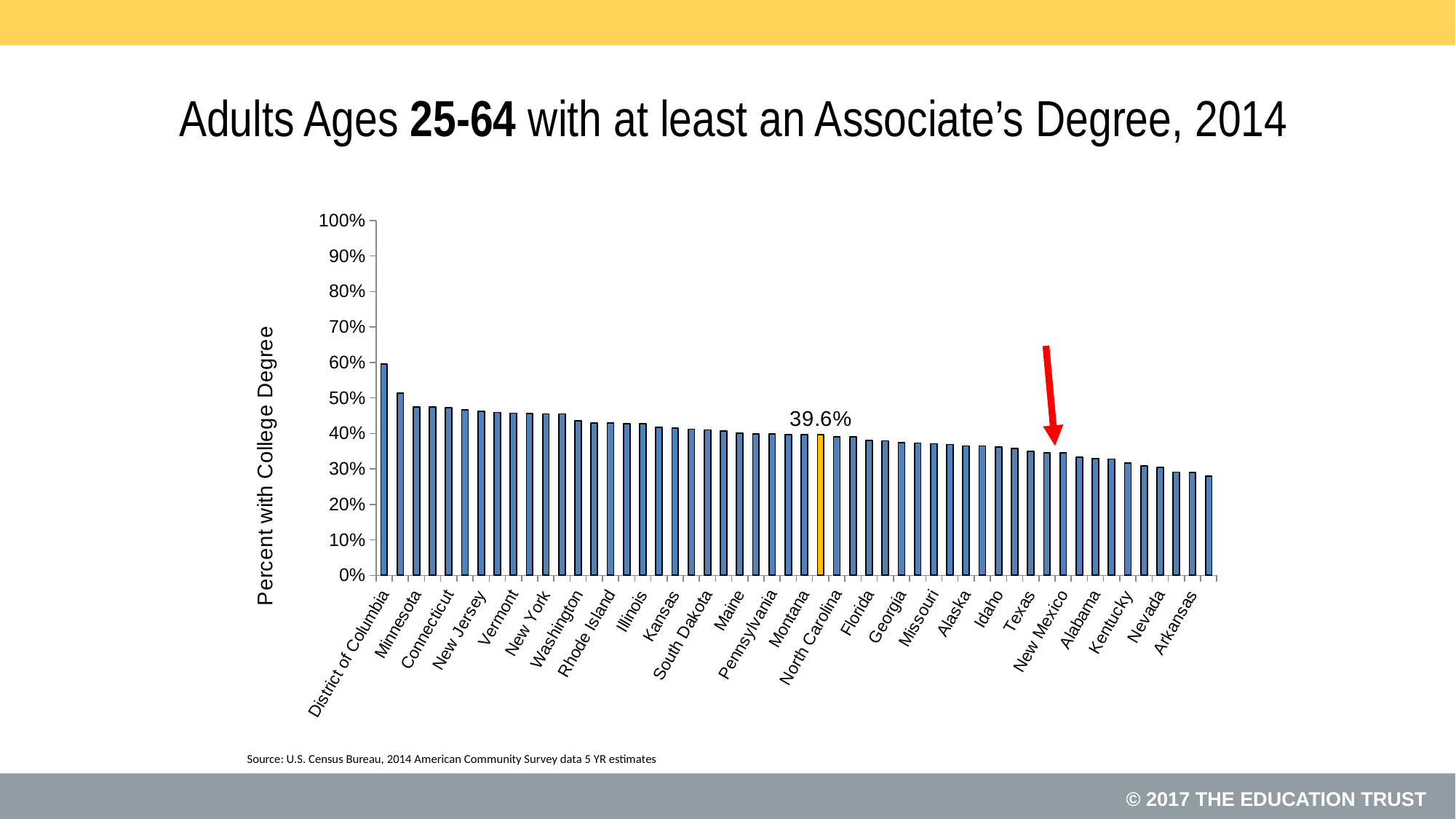
Which is larger, the value for New York or the value for Kentucky? New York Is the value for Texas greater or less than 40%? less Is the value for Connecticut greater or less than 50%? less Is the value for District of Columbia greater or less than 50%? greater What kind of chart is shown on the slide? bar chart Which is larger, the value for District of Columbia or the value for Minnesota? District of Columbia What is the label on the vertical axis? Percent with College Degree What value is printed above the orange highlighted bar? 39.6% Which category has the highest value? District of Columbia Do the values rise or fall moving from left to right along the x axis? fall